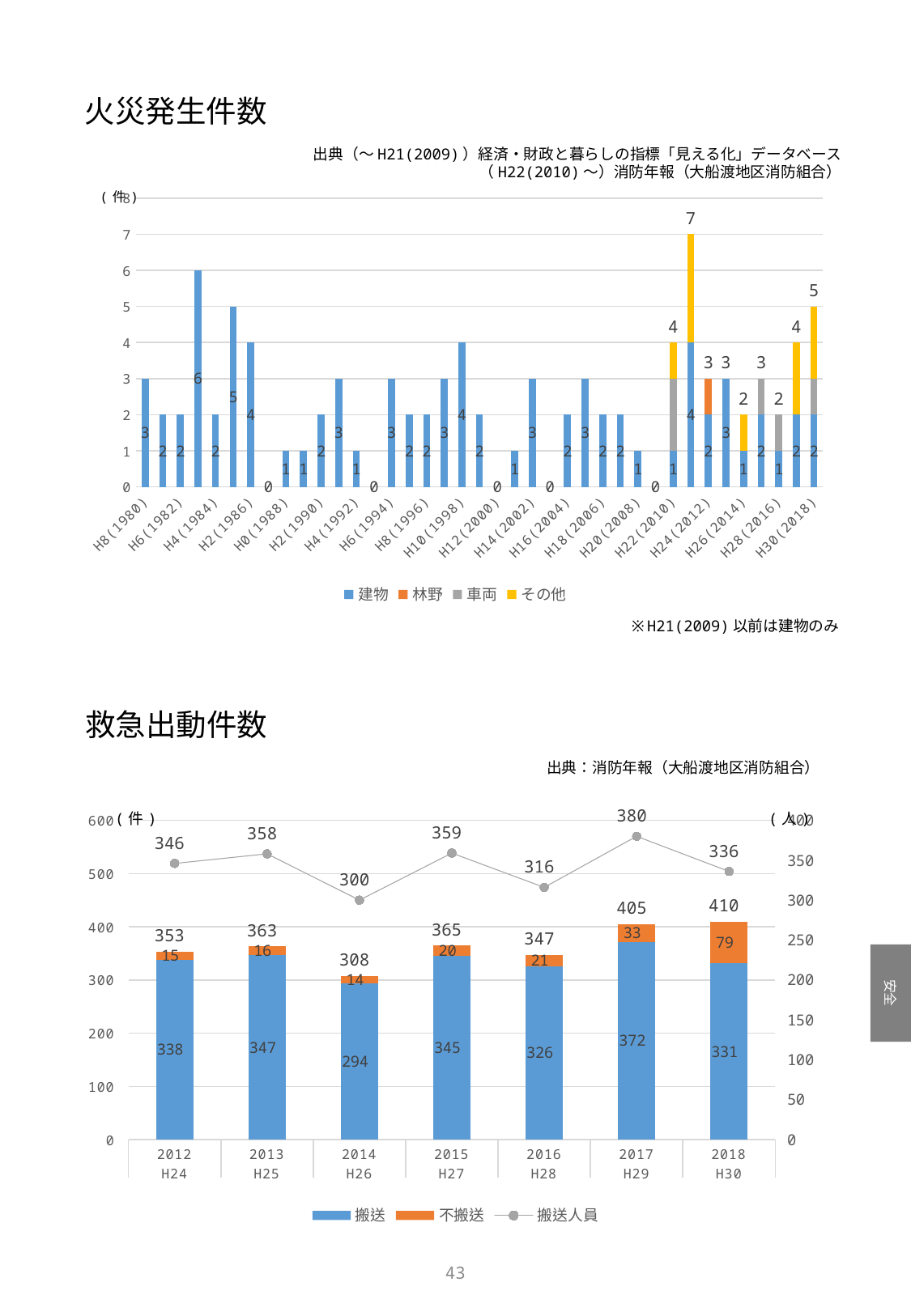
In the 救急出動件数 chart, which year has the highest total number of cases? 2018 (H30) In the 救急出動件数 chart, which year has the larger 搬送 value, 2013 or 2015? 2013 In the 救急出動件数 chart, which year has the lowest 搬送人員 value? 2014 (H26) In the 救急出動件数 chart, what is the 不搬送 value for 2018 (H30)? 79 In the 火災発生件数 chart, which year has the highest total number of fires? H23(2011) How many series does the legend of the 火災発生件数 chart list? 4 In the 救急出動件数 chart, what is the 搬送人員 value for 2017 (H29)? 380 In the 救急出動件数 chart, what is the difference between the total for 2018 (410) and the total for 2017 (405)? 5 How many series does the legend of the 救急出動件数 chart list? 3 In the 火災発生件数 chart, what is the value for H4(1984)? 2 How many years are shown on the x axis of the 救急出動件数 chart? 7 What kind of chart is the 火災発生件数 chart? Stacked bar chart